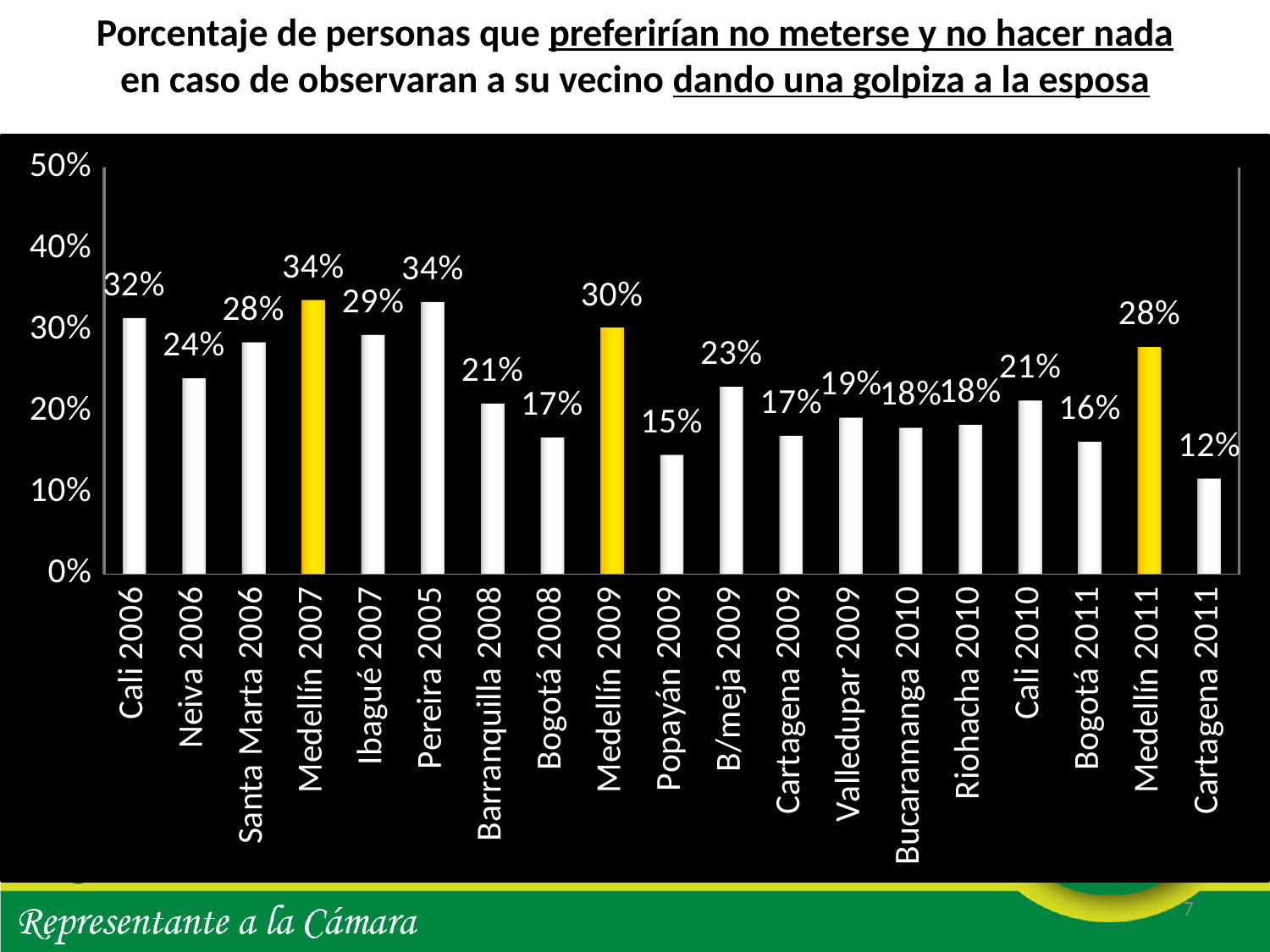
What is the value for Medellín 2011? 28% What is the difference between Medellín 2007 and Medellín 2011? 6% What is the difference between Cali 2006 and Cali 2010? 11% How many categories are shown on the x axis? 19 Which is larger, the value for Neiva 2006 or the value for B/meja 2009? Neiva 2006 What is the value for Barranquilla 2008? 21% Is the value for Medellín 2009 greater or less than 20%? greater What is the value for Popayán 2009? 15% Which category has the lowest value? Cartagena 2011 How many bars are highlighted in yellow? 3 What is the value for Cali 2006? 32% What kind of chart is shown on the slide? bar chart